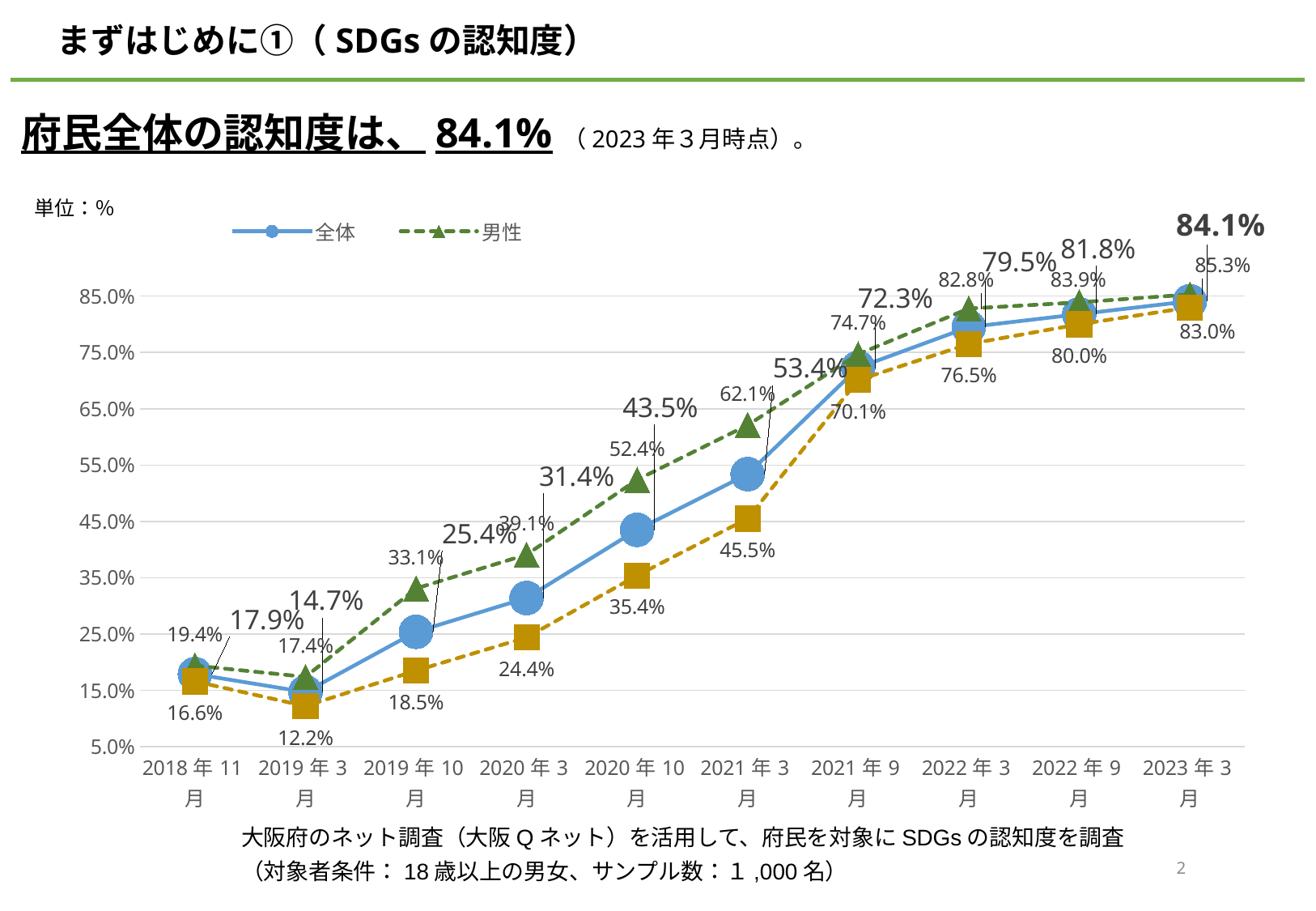
At which survey date is the 男性 value highest? 2023年3月 What is the value for 全体 at 2023年3月? 84.1% What is the value for 男性 at 2019年10月? 33.1% At 2021年9月, which is larger: the 全体 value or the 男性 value? 男性 Does the 全体 value rise or fall from 2019年3月 to 2023年3月? rise What kind of chart is shown on the slide? line chart How many survey dates are shown on the x axis? 10 What is the value for 男性 at 2021年3月? 62.1% At 2020年3月, how much higher is the 男性 value than the 全体 value? 7.7 percentage points By how much did the 全体 value increase from 2018年11月 to 2023年3月? 66.2 percentage points At which survey date is the 全体 value lowest? 2019年3月 What is the value for 全体 at 2019年3月? 14.7%